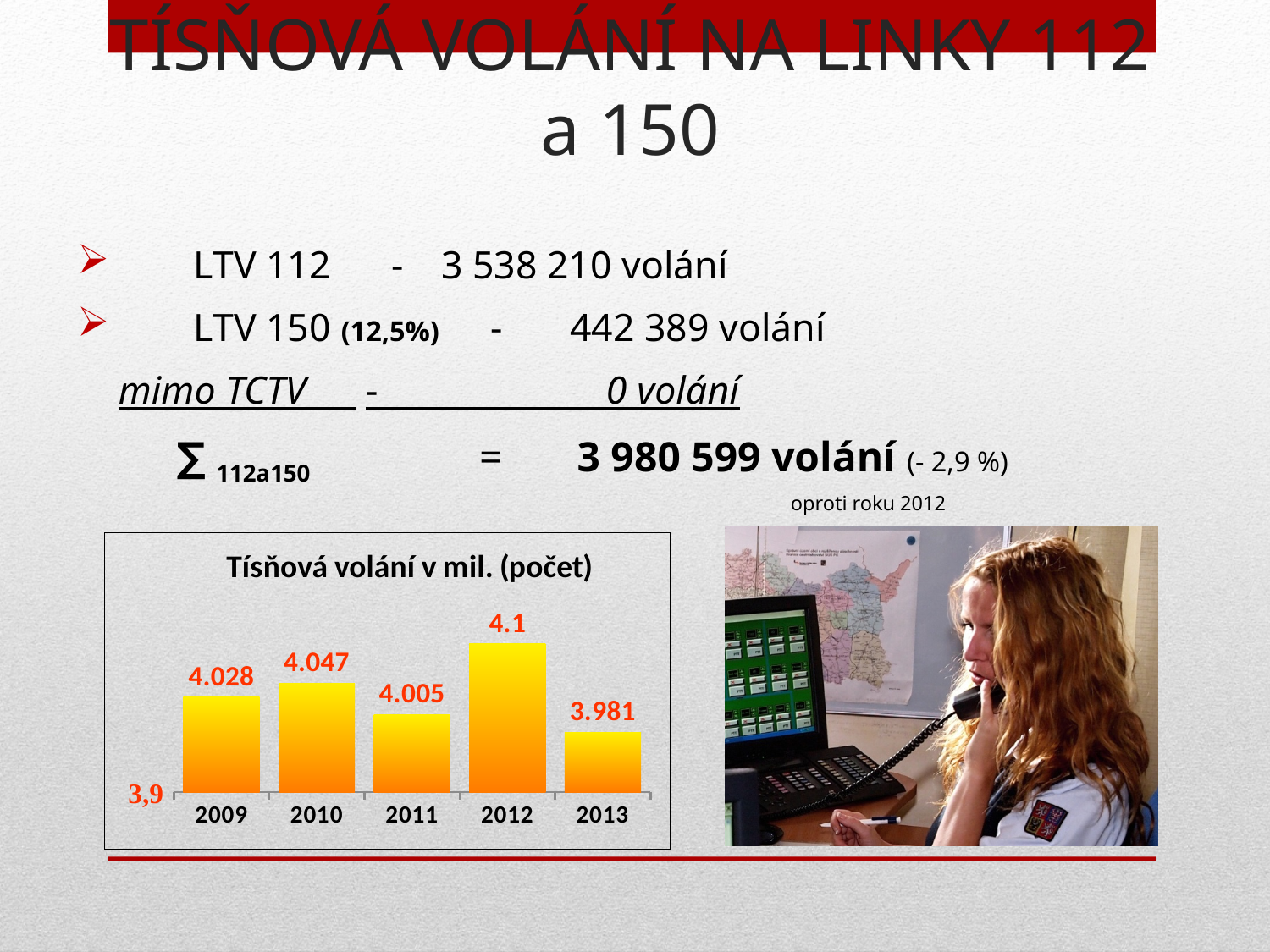
What is the difference between the values for 2012 and 2013? 0.119 What is the title of the chart? Tísňová volání v mil. (počet) Does the value rise or fall from 2012 to 2013? fall How many years are shown in the chart? 5 What is the value for 2013 in the chart? 3.981 What kind of chart is shown on the slide? bar chart What is the value for 2009 in the chart? 4.028 What is the value for 2012 in the chart? 4.1 Which year has the highest value in the chart? 2012 What is the value for 2011 in the chart? 4.005 Which year has the lowest value in the chart? 2013 Which is larger, the value for 2010 or the value for 2011? 2010